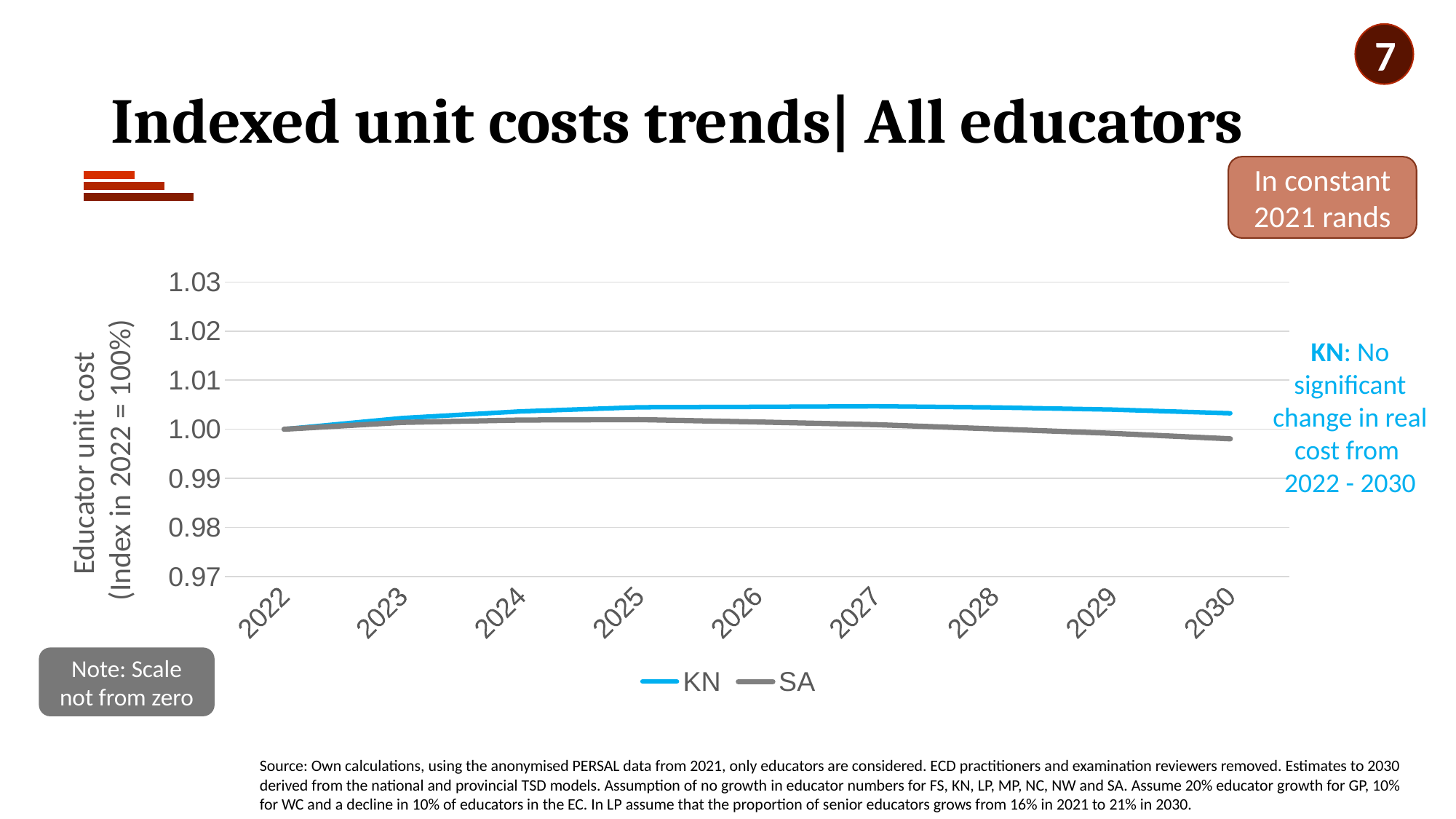
Is the value for SA in 2030 greater or less than 0.99? greater Is the value for KN in 2026 greater or less than 1.01? less What is the title of the chart's vertical axis? Educator unit cost (Index in 2022 = 100%) How many series does the chart legend list? 2 What kind of chart is shown on the slide? line chart How many years are shown along the x axis of the chart? 9 Does the SA series rise or fall between 2025 and 2030? fall In 2030, which series has the higher value, KN or SA? KN Does the KN series rise or fall between 2022 and 2025? rise Which series are listed in the chart legend? KN and SA What is the value of the KN series in 2022? 1.00 What is the value of the SA series in 2022? 1.00